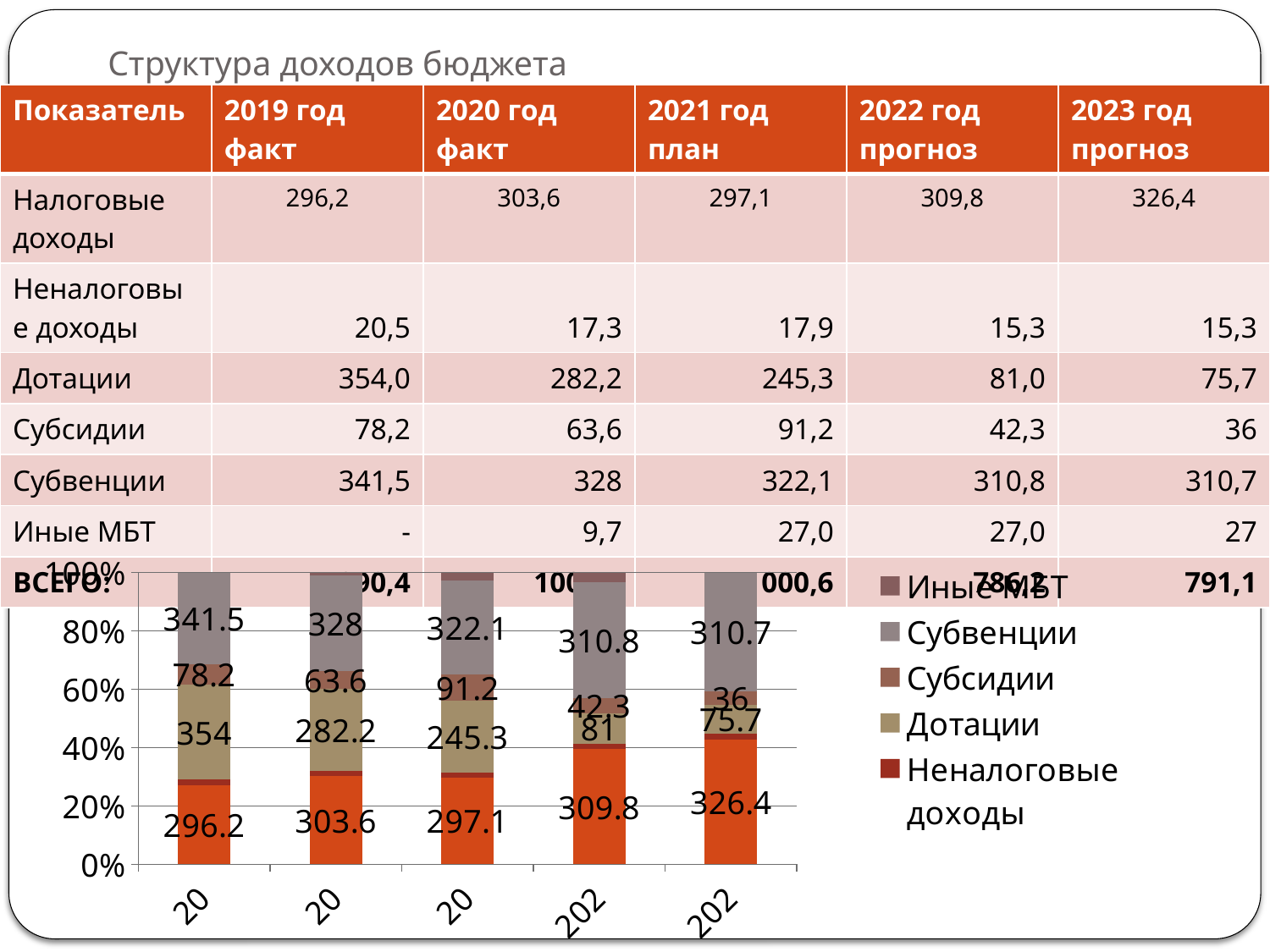
Which bar in the chart has the smallest Дотации label? The rightmost bar (75.7) How many series does the chart legend list? 5 What kind of chart is shown at the bottom of the slide? Stacked bar chart Which is larger in the chart: the Субсидии label on the third bar or on the fourth bar? The third bar (91.2) What is the Субвенции data label on the leftmost bar of the chart? 341.5 What is the Субсидии data label on the fourth bar from the left in the chart? 42.3 How many bars are plotted in the chart? 5 Which bar in the chart has the largest Дотации label? The leftmost bar (354) What is the data label of the bottom segment of the rightmost bar in the chart? 326.4 Do the Дотации labels rise or fall from the leftmost bar to the rightmost bar in the chart? Fall What is the difference between the Дотации labels on the leftmost bar and the rightmost bar in the chart? 278.3 What is the Дотации data label on the third bar from the left in the chart? 245.3